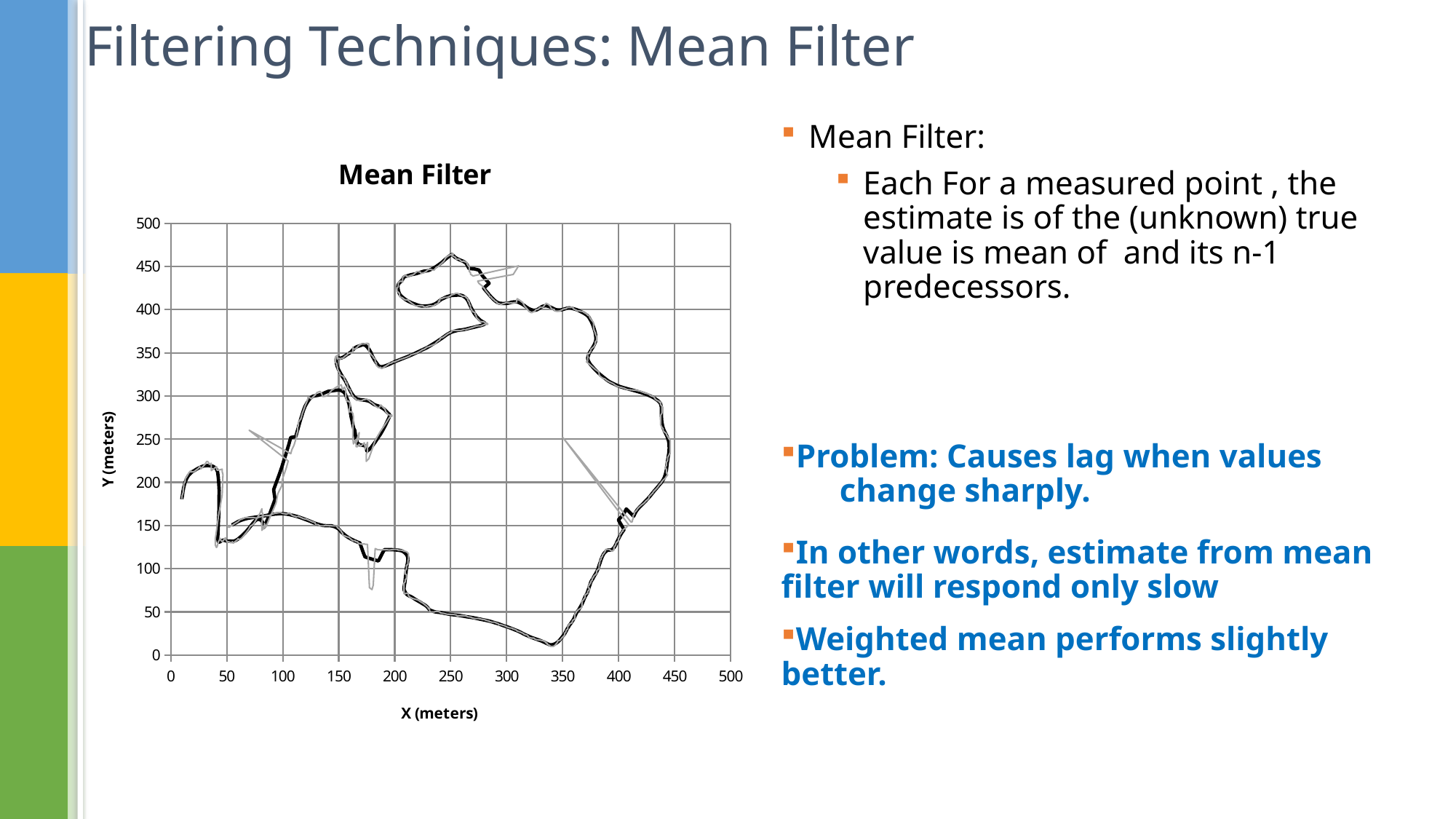
What is the highest value shown on the X (meters) axis? 500 What is the highest value shown on the Y (meters) axis? 500 What kind of chart is shown on the slide? scatter chart Is the lowest Y value reached by the plotted path greater or less than 50? less Is the largest X value reached by the plotted path greater or less than 400? greater Is the smallest X value reached by the plotted path greater or less than 50? less What is the title of the chart? Mean Filter What is the label of the horizontal axis of the chart? X (meters)